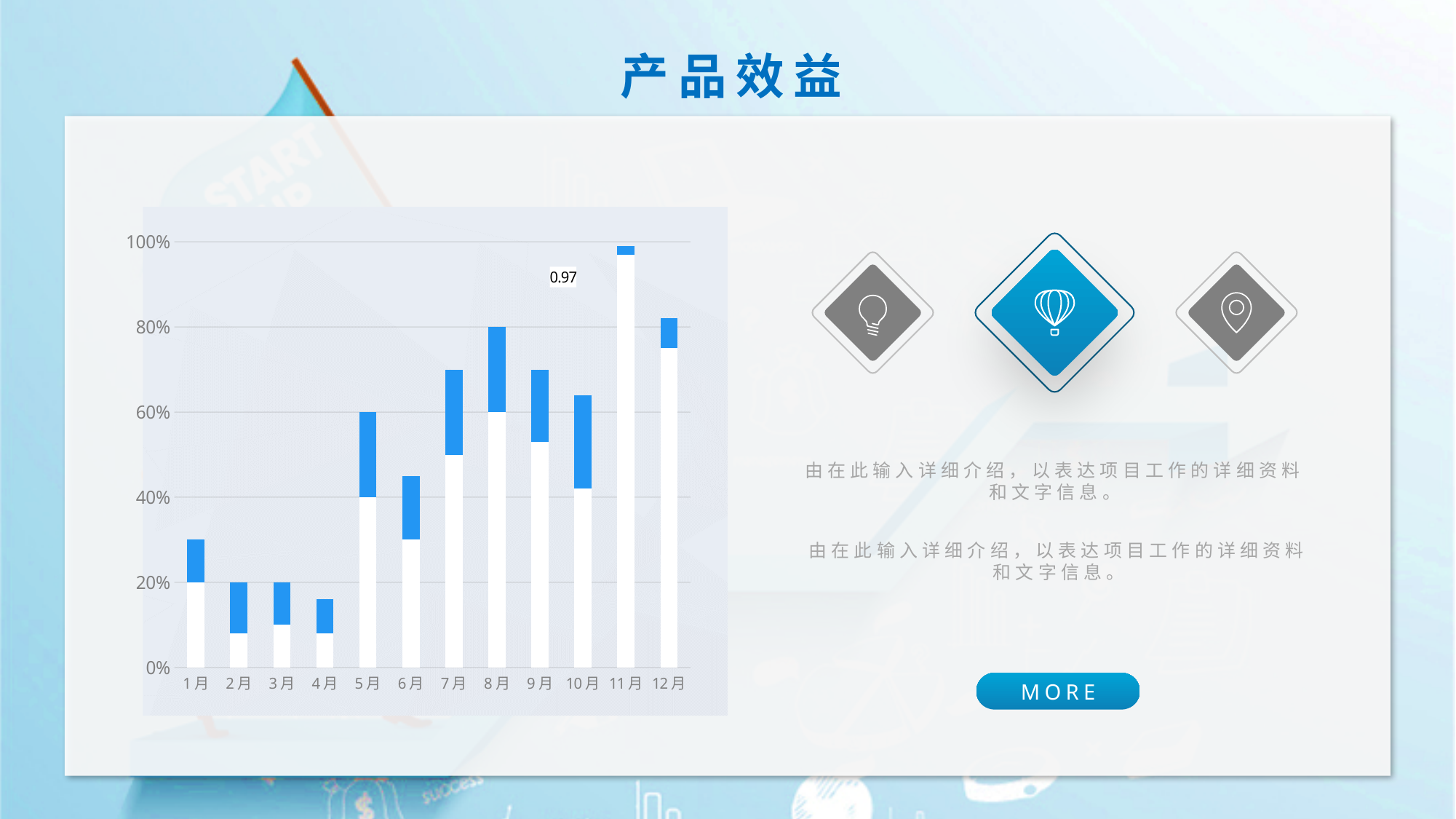
Is the value for 1月 greater or less than 40%? less Is the value for 8月 greater or less than 60%? greater Do the bar values generally rise or fall from 1月 to 12月? rise Which month has the highest bar in the chart? 11月 What is the title shown above the chart on the slide? 产品效益 Which is larger, the bar for 7月 or the bar for 8月? 8月 Is the value for 6月 greater or less than 60%? less Which month has the lowest bar in the chart? 4月 How many months are shown on the x axis of the chart? 12 What kind of chart is shown on the slide? bar chart